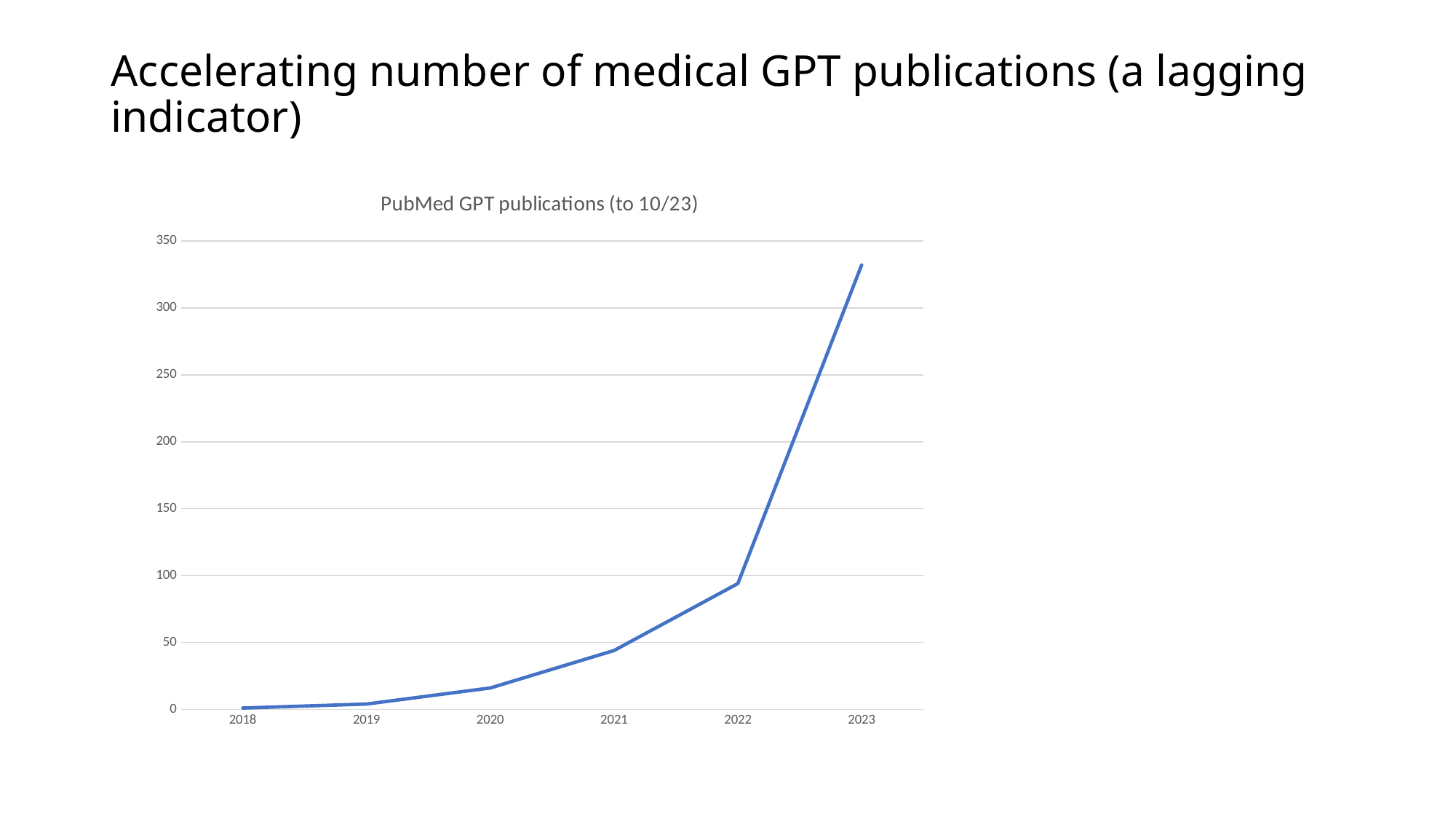
Which year has the highest number of PubMed GPT publications? 2023 Is the value for 2023 greater or less than 300? greater Which year has the larger value, 2022 or 2021? 2022 How many years are plotted on the x axis? 6 What is the first year shown on the x axis? 2018 Is the value for 2022 greater or less than 100? less Which year has the lowest number of PubMed GPT publications? 2018 What is the title of the chart? PubMed GPT publications (to 10/23) What kind of chart is shown on the slide? line chart Is the value for 2021 greater or less than 50? less Do the values rise or fall from 2018 to 2023? rise